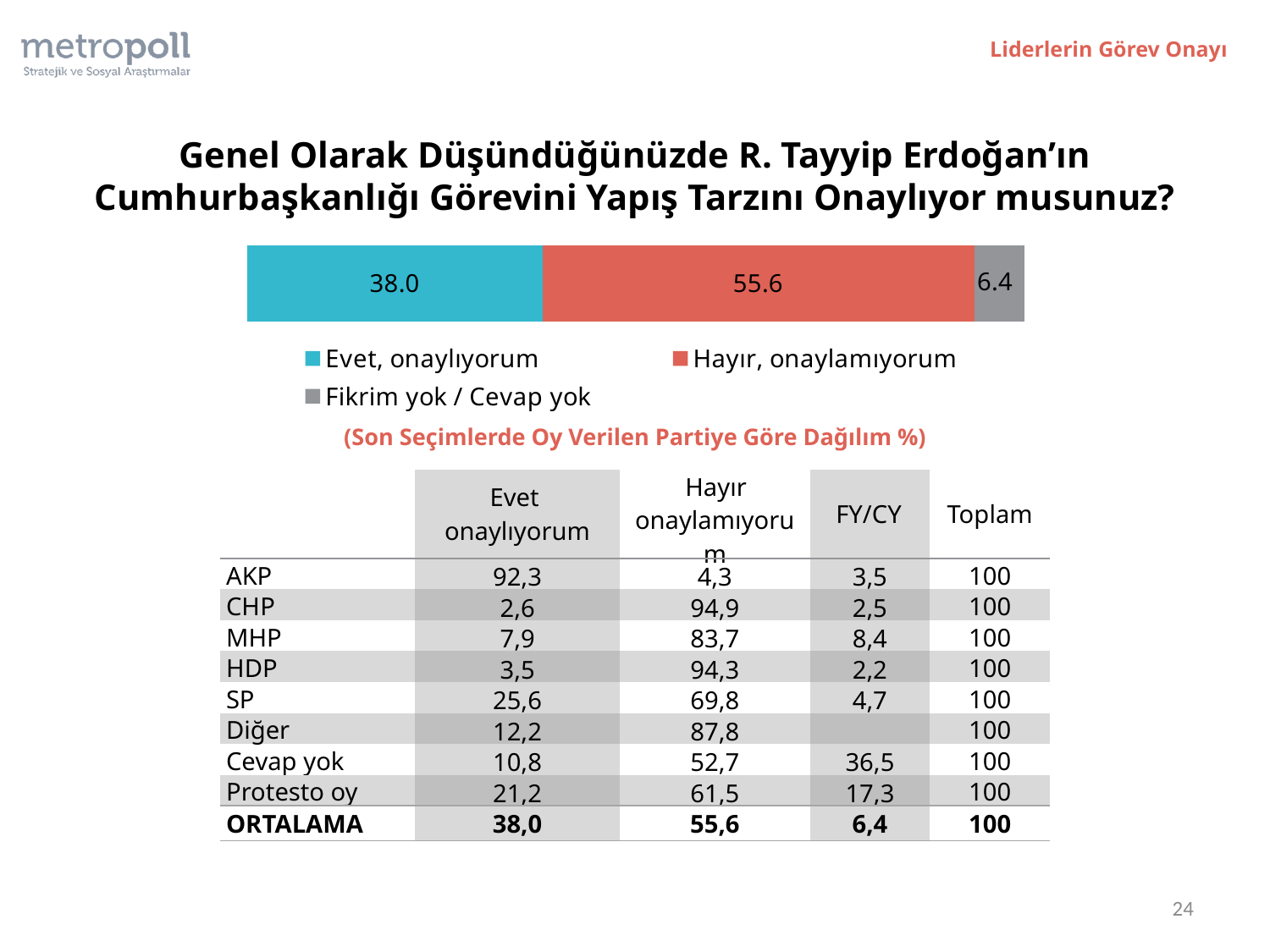
What value is shown for the "Hayır, onaylamıyorum" segment of the bar? 55.6 Which is larger, the "Evet, onaylıyorum" segment or the "Fikrim yok / Cevap yok" segment? Evet, onaylıyorum What value is shown for the "Fikrim yok / Cevap yok" segment of the bar? 6.4 What value is shown for the "Evet, onaylıyorum" segment of the bar? 38.0 What colour is the "Evet, onaylıyorum" segment of the bar? Teal/blue Which legend category has the largest segment in the bar? Hayır, onaylamıyorum How many series does the chart legend list? 3 What colour is the "Hayır, onaylamıyorum" segment of the bar? Red Which legend category has the smallest segment in the bar? Fikrim yok / Cevap yok What kind of chart is shown on the slide? Stacked bar chart What is the difference between the "Hayır, onaylamıyorum" value and the "Evet, onaylıyorum" value? 17.6 What is the total of the three segments in the stacked bar? 100.0